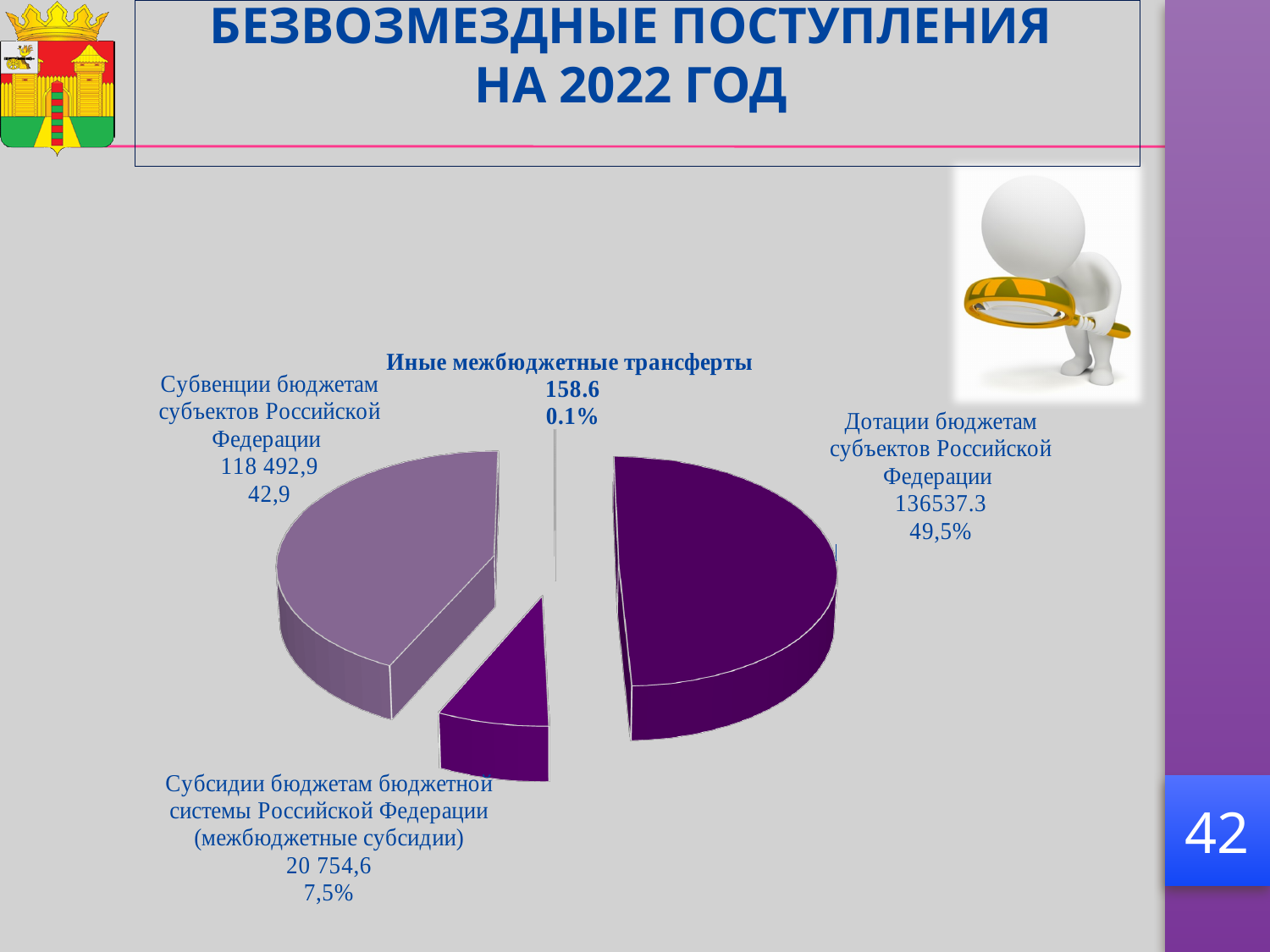
Which is larger: the value for Субвенции бюджетам субъектов Российской Федерации or the value for Субсидии бюджетам бюджетной системы Российской Федерации (межбюджетные субсидии)? Субвенции бюджетам субъектов Российской Федерации How many slices does the pie chart have? 4 What is the value shown for Дотации бюджетам субъектов Российской Федерации? 136537.3 What is the value shown for Иные межбюджетные трансферты? 158.6 What kind of chart is shown on the slide? pie chart Which category has the largest slice of the pie? Дотации бюджетам субъектов Российской Федерации What is the value shown for Субсидии бюджетам бюджетной системы Российской Федерации (межбюджетные субсидии)? 20 754,6 What share of the pie is Субсидии бюджетам бюджетной системы Российской Федерации (межбюджетные субсидии)? 7,5% What is the title of the slide containing the pie chart? БЕЗВОЗМЕЗДНЫЕ ПОСТУПЛЕНИЯ НА 2022 ГОД What is the value shown for Субвенции бюджетам субъектов Российской Федерации? 118 492,9 What share of the pie is Дотации бюджетам субъектов Российской Федерации? 49,5% Which category has the smallest slice of the pie? Иные межбюджетные трансферты